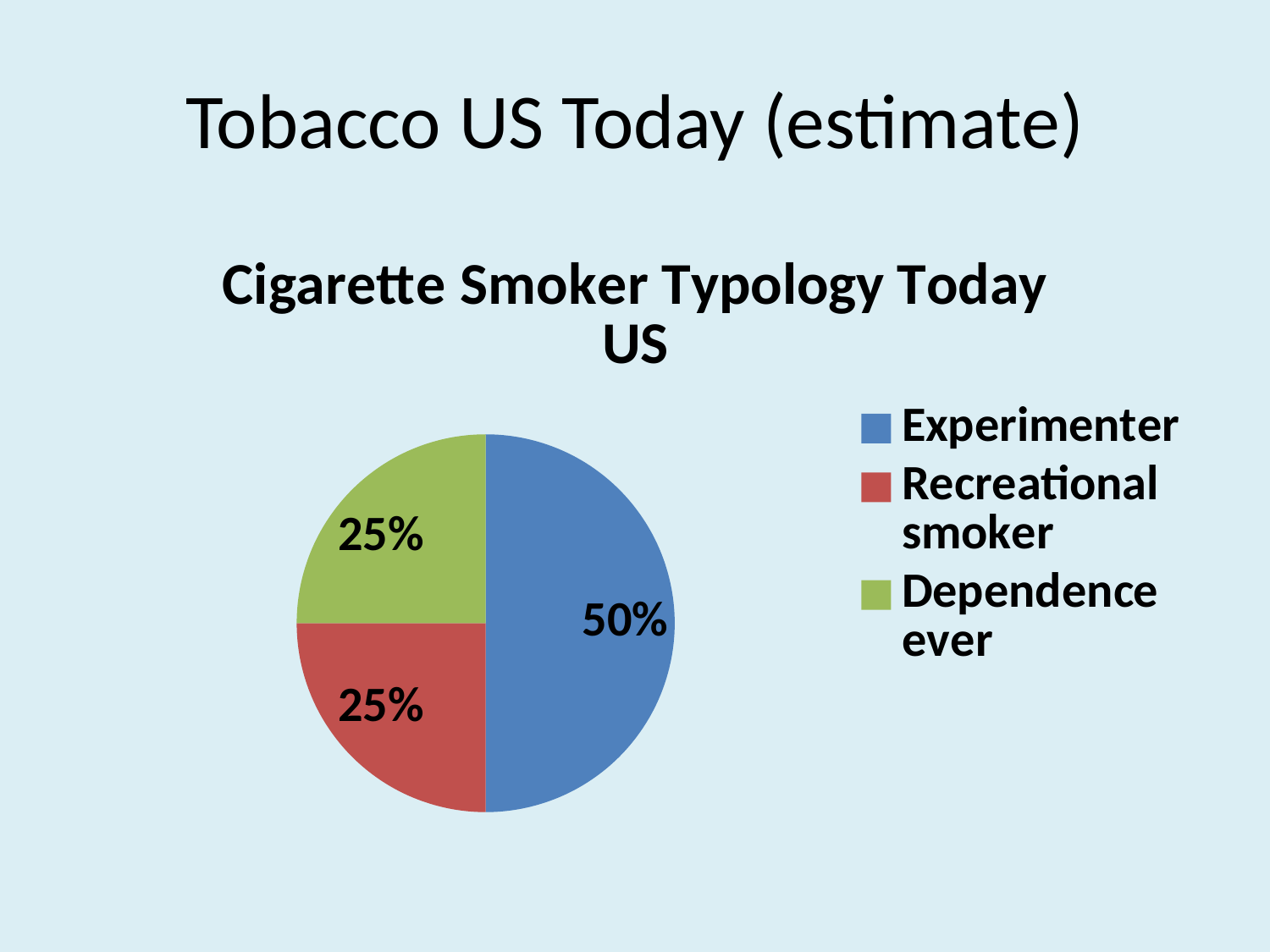
What is the title of the chart? Cigarette Smoker Typology Today US How many slices does the pie chart have? 3 What colour is the Dependence ever slice? green What kind of chart is shown on the slide? pie chart What share of the pie is Recreational smoker? 25% Which is larger, the Experimenter slice or the Dependence ever slice? Experimenter What share of the pie is Experimenter? 50% What is the combined share of Recreational smoker and Dependence ever? 50% What share of the pie is Dependence ever? 25% Which category has the largest slice of the pie? Experimenter How many entries does the legend list? 3 What is the difference between the Experimenter share and the Recreational smoker share? 25%